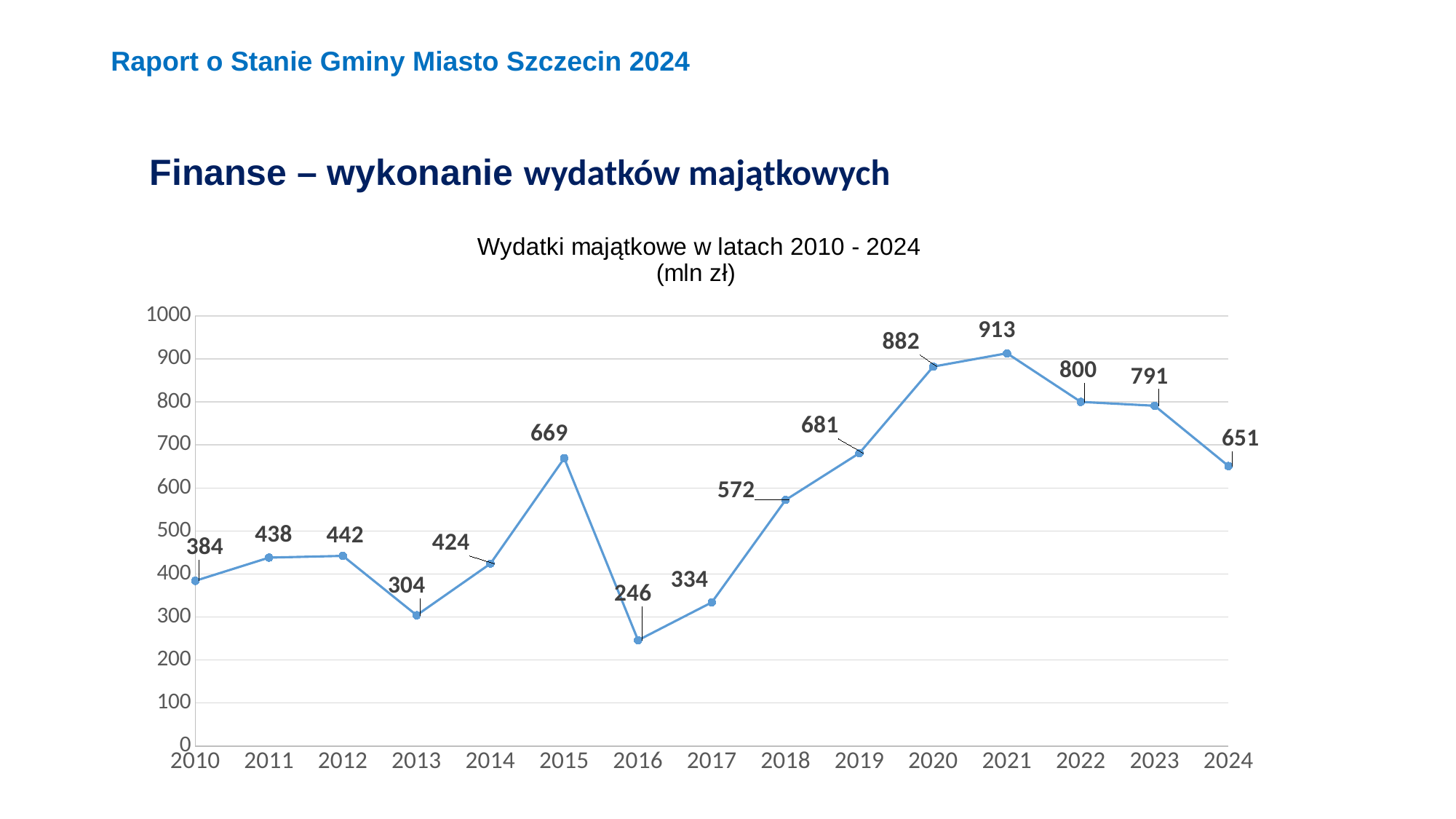
Is the value for 2020 greater or less than 800? greater How many years are plotted on the chart? 15 What is the title of the chart? Wydatki majątkowe w latach 2010 - 2024 (mln zł) Which year has the lowest value? 2016 What is the difference between the values for 2024 and 2023? 140 What is the difference between the values for 2021 and 2016? 667 Which year has the highest value? 2021 What is the value for 2015? 669 What is the value for 2021? 913 What is the value for 2024? 651 Which is larger, the value for 2011 or the value for 2012? 2012 What kind of chart is shown? line chart